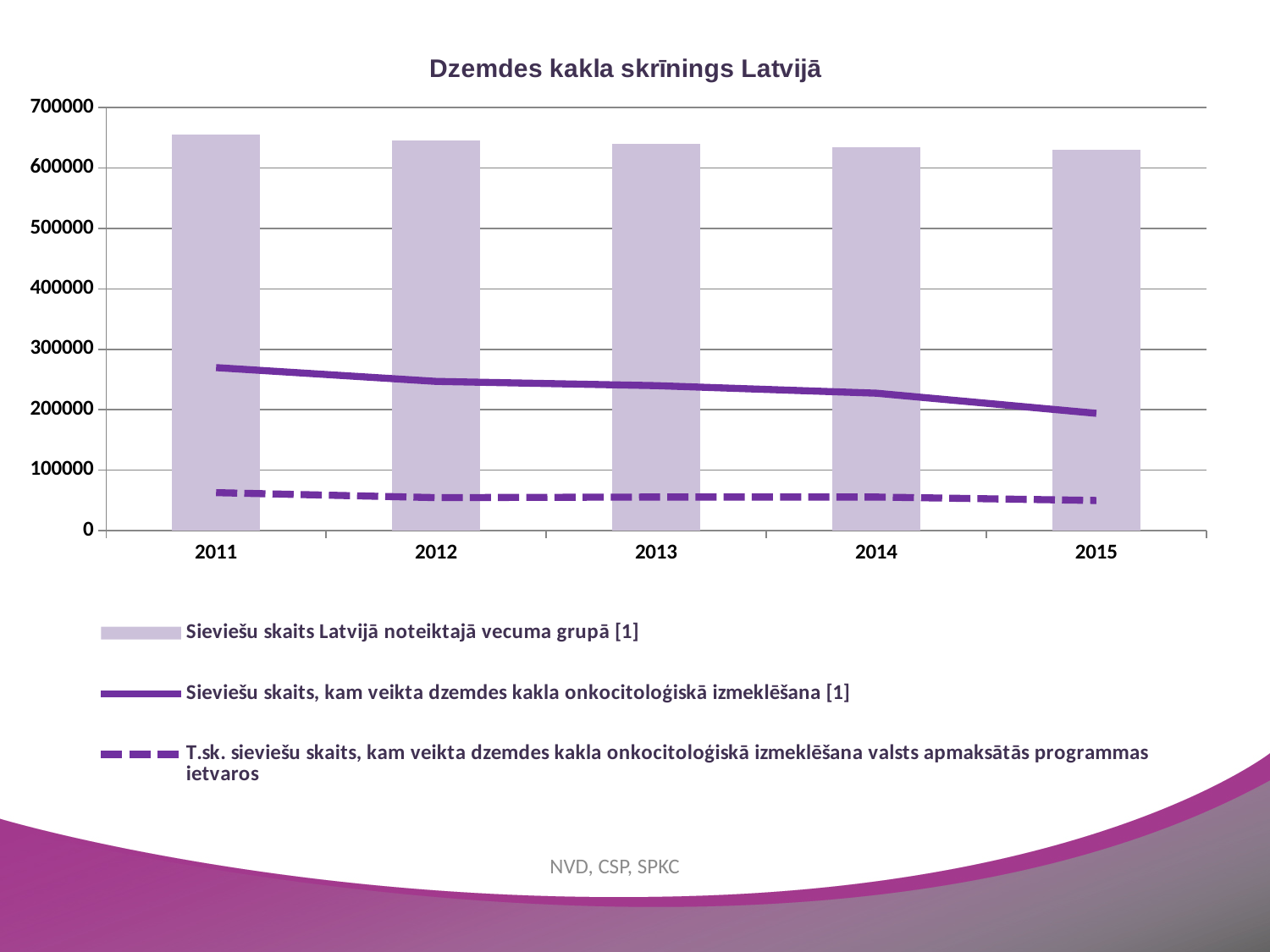
Which is larger: the solid line value in 2011 or in 2015? 2011 In which year is the solid line 'Sieviešu skaits, kam veikta dzemdes kakla onkocitoloģiskā izmeklēšana [1]' at its lowest? 2015 Is the value of the dashed line in 2011 greater or less than 100000? less Does the solid line for women who had a cervical cytology examination rise or fall from 2011 to 2015? Fall What is the title of the chart? Dzemdes kakla skrīnings Latvijā Is the value of the bar for 2011 greater or less than 600000? greater How many years are shown on the x axis of the chart? 5 Which year has the tallest bar for 'Sieviešu skaits Latvijā noteiktajā vecuma grupā [1]'? 2011 What kind of chart is shown on the slide? A combined bar and line chart How many series does the legend list? 3 In which year is the solid line 'Sieviešu skaits, kam veikta dzemdes kakla onkocitoloģiskā izmeklēšana [1]' at its highest? 2011